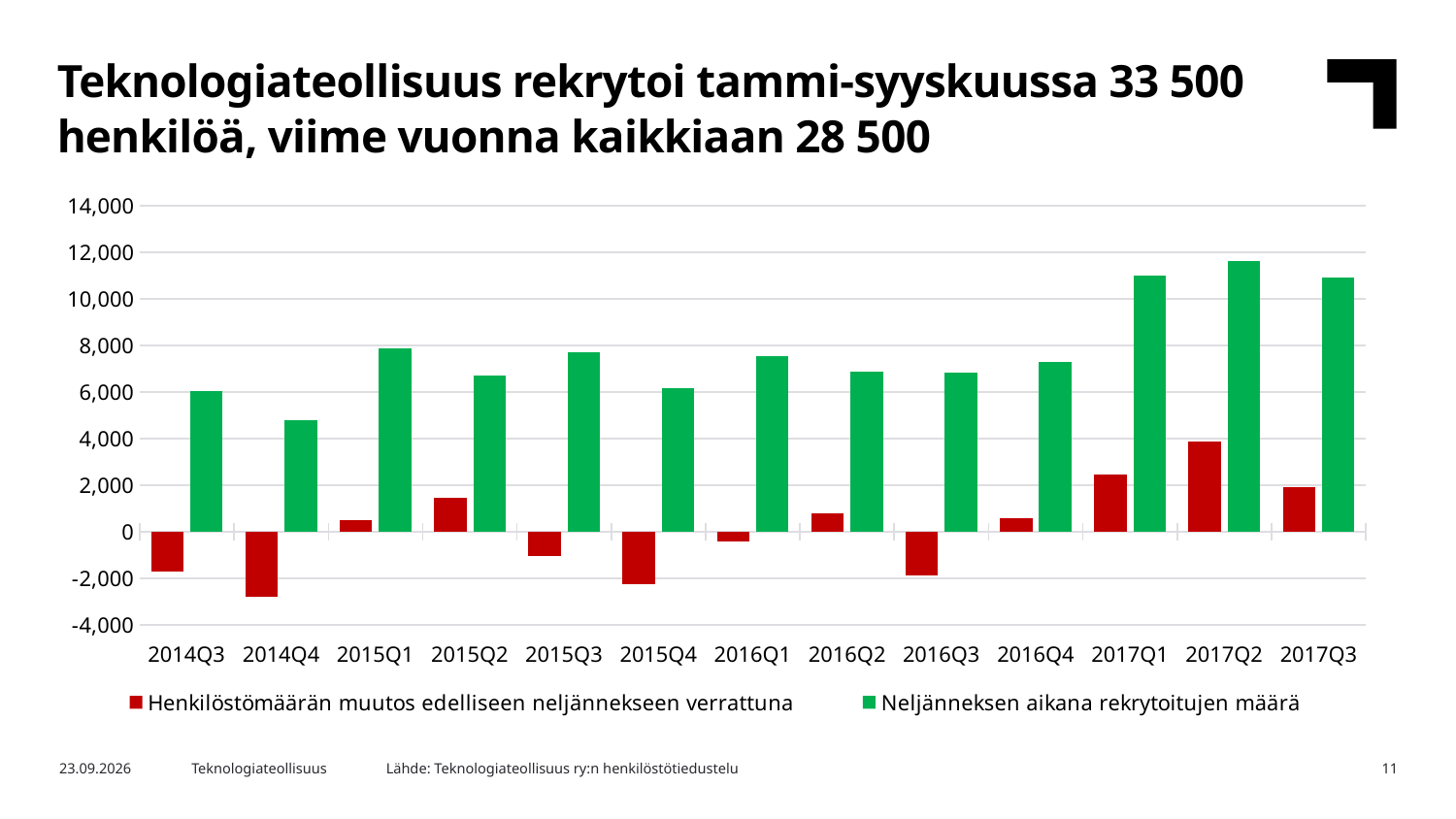
What kind of chart is shown on the slide? bar chart How many series does the chart's legend list? 2 Which quarter has the lowest value for 'Henkilöstömäärän muutos edelliseen neljännekseen verrattuna'? 2014Q4 How many quarters are shown on the x axis of the chart? 13 Is the value for 'Henkilöstömäärän muutos edelliseen neljännekseen verrattuna' in 2017Q2 greater or less than 2,000? greater Which colour represents 'Neljänneksen aikana rekrytoitujen määrä' in the chart? green Is the value for 'Neljänneksen aikana rekrytoitujen määrä' in 2014Q4 greater or less than 6,000? less Is the value for 'Neljänneksen aikana rekrytoitujen määrä' in 2017Q1 greater or less than 10,000? greater Which quarter has the larger value for 'Neljänneksen aikana rekrytoitujen määrä', 2014Q4 or 2015Q1? 2015Q1 Which quarter has the highest value for 'Henkilöstömäärän muutos edelliseen neljännekseen verrattuna'? 2017Q2 Which quarter has the highest value for 'Neljänneksen aikana rekrytoitujen määrä'? 2017Q2 Which quarter has the lowest value for 'Neljänneksen aikana rekrytoitujen määrä'? 2014Q4